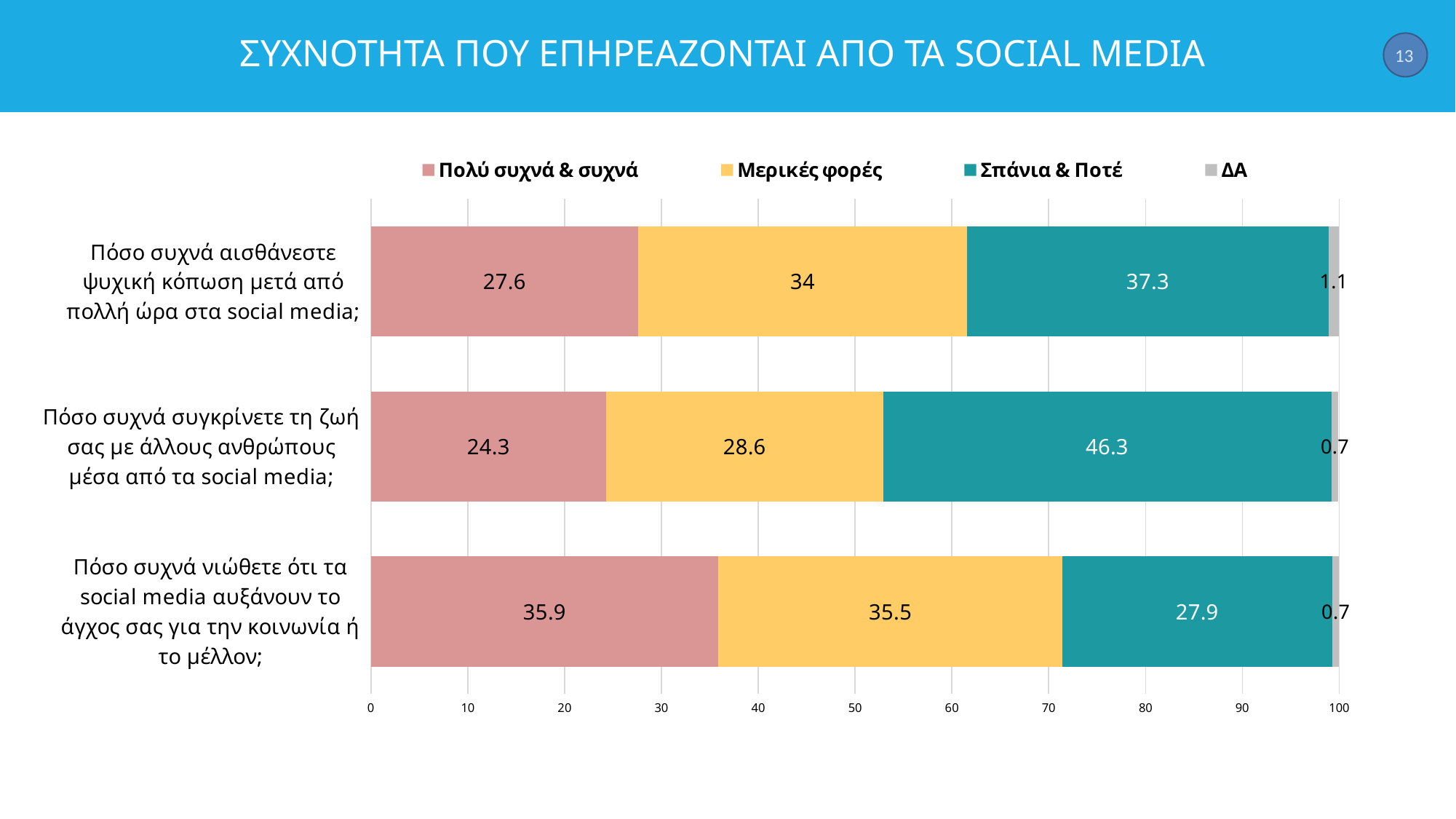
Which category has the highest value for 'Σπάνια & Ποτέ'? Πόσο συχνά συγκρίνετε τη ζωή σας με άλλους ανθρώπους μέσα από τα social media; What is the value of 'Μερικές φορές' for 'Πόσο συχνά νιώθετε ότι τα social media αυξάνουν το άγχος σας για την κοινωνία ή το μέλλον;'? 35.5 How many categories (questions) are plotted on the chart? 3 How many series does the legend list? 4 For 'Πόσο συχνά αισθάνεστε ψυχική κόπωση μετά από πολλή ώρα στα social media;', which is larger: 'Μερικές φορές' or 'Σπάνια & Ποτέ'? Σπάνια & Ποτέ What type of chart is shown on the slide? Stacked bar chart What is the difference between the 'Σπάνια & Ποτέ' values for 'Πόσο συχνά συγκρίνετε τη ζωή σας με άλλους ανθρώπους μέσα από τα social media;' and 'Πόσο συχνά νιώθετε ότι τα social media αυξάνουν το άγχος σας για την κοινωνία ή το μέλλον;'? 18.4 What is the value of 'ΔΑ' for 'Πόσο συχνά αισθάνεστε ψυχική κόπωση μετά από πολλή ώρα στα social media;'? 1.1 What is the total of the stacked bar for 'Πόσο συχνά αισθάνεστε ψυχική κόπωση μετά από πολλή ώρα στα social media;'? 100 What is the value of 'Σπάνια & Ποτέ' for 'Πόσο συχνά συγκρίνετε τη ζωή σας με άλλους ανθρώπους μέσα από τα social media;'? 46.3 What is the value of 'Πολύ συχνά & συχνά' for 'Πόσο συχνά αισθάνεστε ψυχική κόπωση μετά από πολλή ώρα στα social media;'? 27.6 Which category has the lowest value for 'Πολύ συχνά & συχνά'? Πόσο συχνά συγκρίνετε τη ζωή σας με άλλους ανθρώπους μέσα από τα social media;